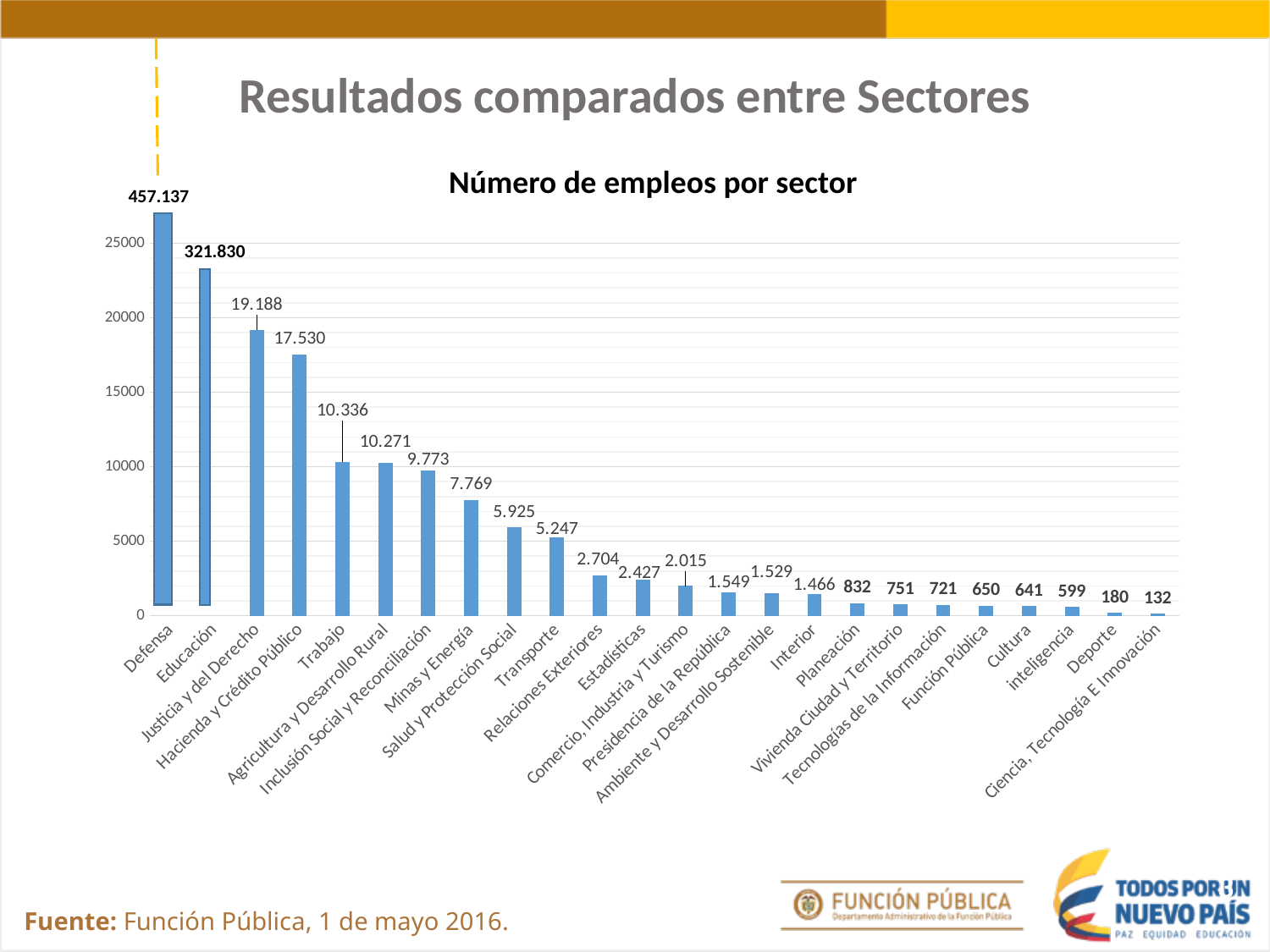
What is the value shown for Función Pública? 650 What value is shown for Hacienda y Crédito Público? 17.530 How many sectors are shown on the chart? 24 What is the number of employees for the Defensa sector? 457.137 What is the title of the chart? Número de empleos por sector What is the difference between the values for Deporte and Ciencia, Tecnología E Innovación? 48 What is the value for Transporte? 5.247 Which sector has the lowest number of employees? Ciencia, Tecnología E Innovación Which has a larger value, Minas y Energía or Salud y Protección Social? Minas y Energía What is the difference between the values for Justicia y del Derecho and Hacienda y Crédito Público? 1.658 Is the value for Minas y Energía greater or less than 5000? greater Which sector has the highest number of employees? Defensa